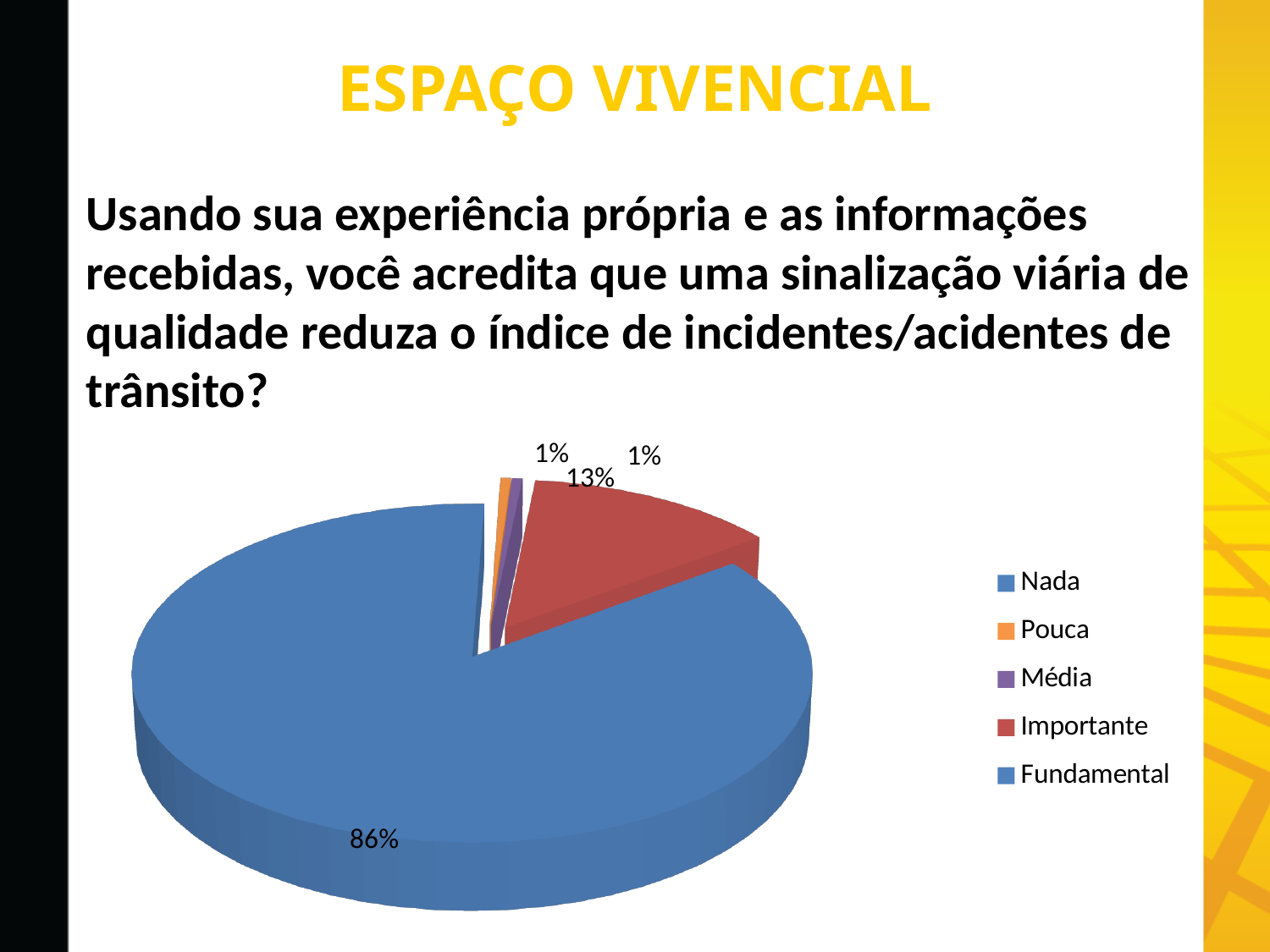
Which slice is larger, Importante or Fundamental? Fundamental What kind of chart is shown on the slide? Pie chart What percentage does the Média slice represent in the pie chart? 1% What share of the pie does the Fundamental slice take? 86% What percentage of the pie chart is the Fundamental slice? 86% How many entries does the legend of the pie chart list? 5 What percentage of the pie chart is the Importante slice? 13% What colour represents Importante in the pie chart legend? Red Which category has the largest slice of the pie chart? Fundamental Which legend entry is listed first in the pie chart legend? Nada What is the difference in percentage points between the Fundamental and Importante slices? 73 percentage points What percentage does the Pouca slice represent in the pie chart? 1%